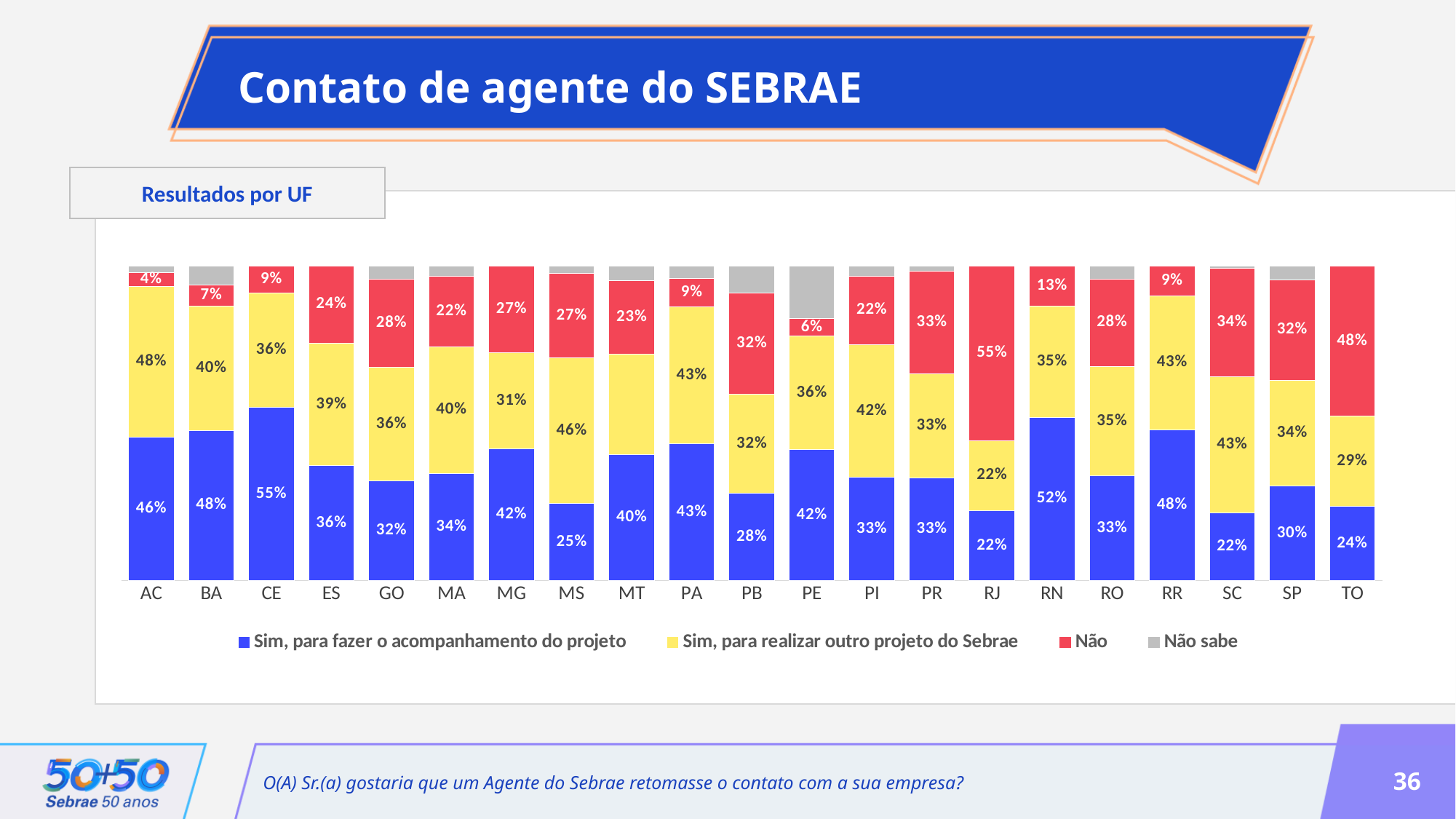
What is the value of 'Não' for TO? 48% What kind of chart is shown on the slide? Stacked bar chart Which UF has the lowest value for 'Não'? AC Which UF has the highest value for 'Sim, para fazer o acompanhamento do projeto'? CE What is the value of 'Sim, para fazer o acompanhamento do projeto' for CE? 55% What is the difference between the 'Sim, para fazer o acompanhamento do projeto' values for CE and SC? 33 percentage points Which UF has the highest value for 'Não'? RJ How many UFs (categories) are shown on the x axis? 21 What is the value of 'Não' for RJ? 55% Which has a larger 'Sim, para fazer o acompanhamento do projeto' value, RN or RR? RN How many series does the legend list? 4 What is the value of 'Sim, para realizar outro projeto do Sebrae' for MS? 46%